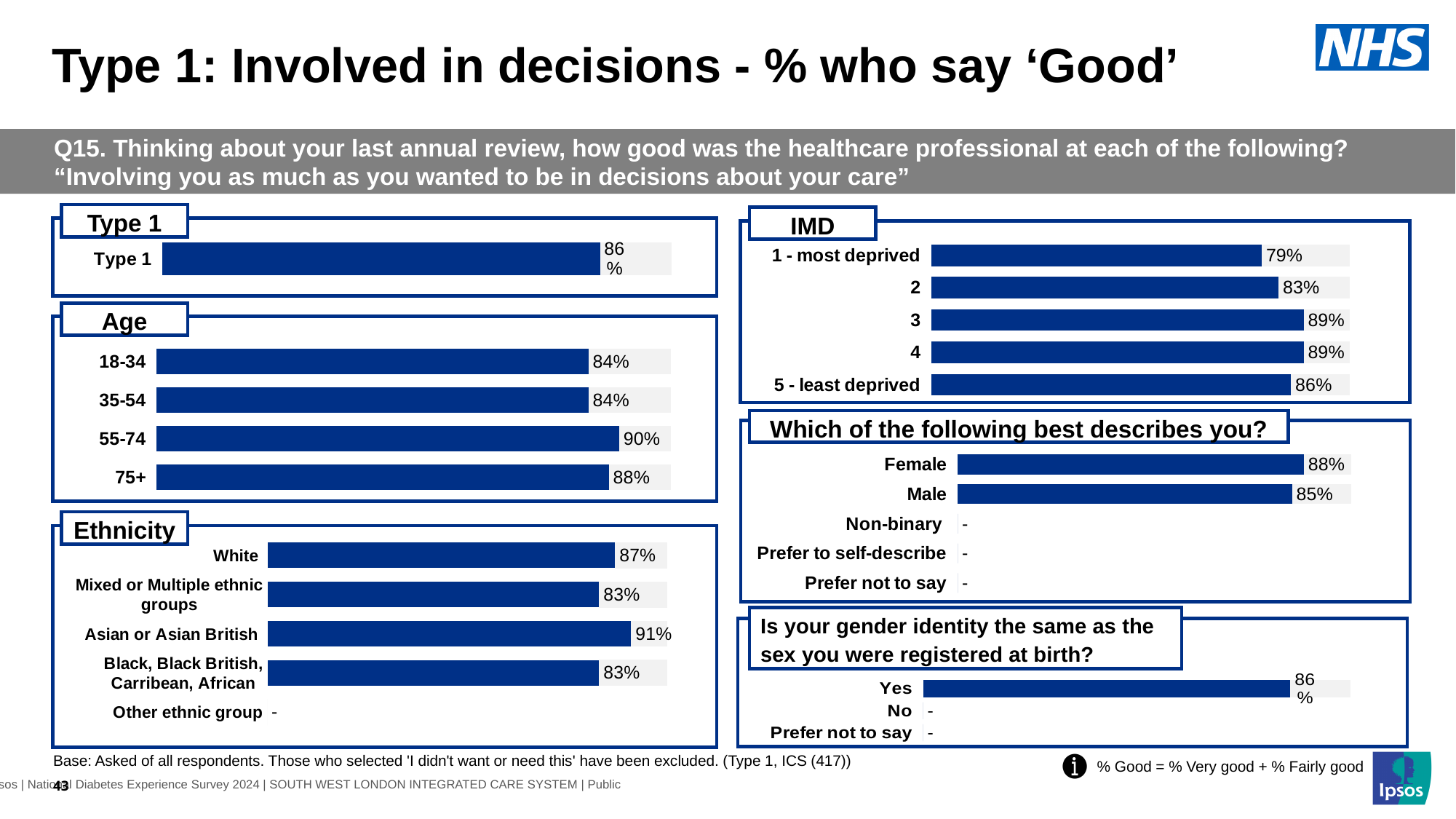
In the Type 1 chart, what is the value for Type 1? 86% In the Age chart, what is the value for 55-74? 90% In the 'Is your gender identity the same as the sex you were registered at birth?' chart, what is the value for Yes? 86% In the IMD chart, what is the value for 1 - most deprived? 79% What kind of chart is the Age chart? Bar chart In the Ethnicity chart, what is the difference between White and Mixed or Multiple ethnic groups? 4 percentage points In the 'Which of the following best describes you?' chart, what is the value for Male? 85% In the 'Which of the following best describes you?' chart, which is larger, Female or Male? Female In the IMD chart, which category has the lowest value? 1 - most deprived In the Ethnicity chart, what is the value for Asian or Asian British? 91% In the Age chart, which age group has the highest value? 55-74 In the IMD chart, how many categories are shown? 5